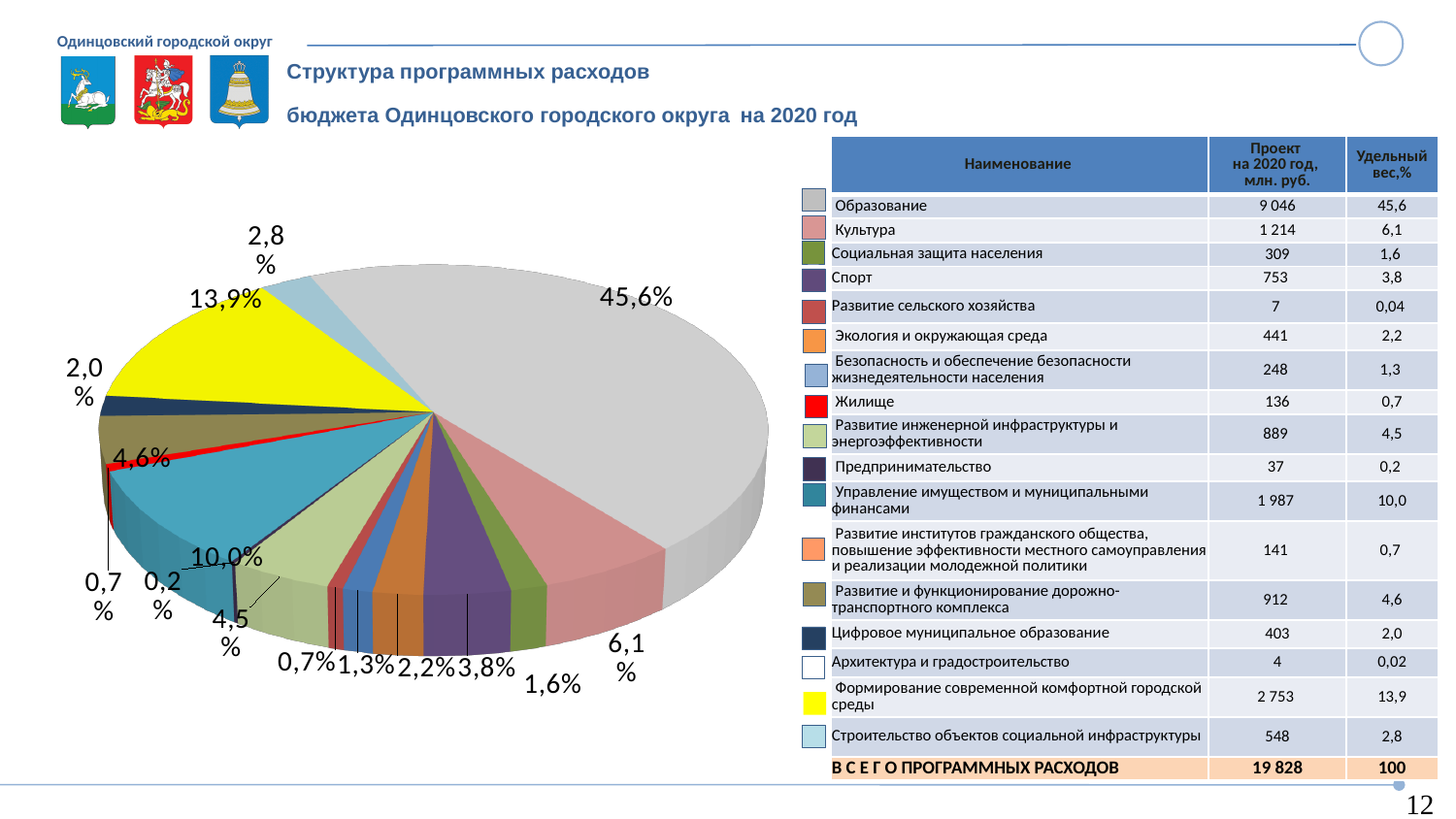
What is the largest slice of the pie chart? 45,6% What kind of chart is shown on the slide? pie chart Which category has the largest share of programme expenditures in the pie chart? Образование What share does Строительство объектов социальной инфраструктуры have in the pie chart? 2,8% What colour is the largest slice of the pie chart? grey What share does Управление имуществом и муниципальными финансами have in the pie chart? 10,0% What is the difference in percentage points between the 45,6% slice and the 13,9% slice? 31,7 What is the title of the chart on the slide? Структура программных расходов бюджета Одинцовского городского округа на 2020 год Which is larger in the pie chart: the 13,9% slice or the 10,0% slice? 13,9% What share does Культура have in the pie chart? 6,1% What share does the yellow slice (Формирование современной комфортной городской среды) have in the pie chart? 13,9% What is the difference in percentage points between the 10,0% slice and the 4,6% slice? 5,4